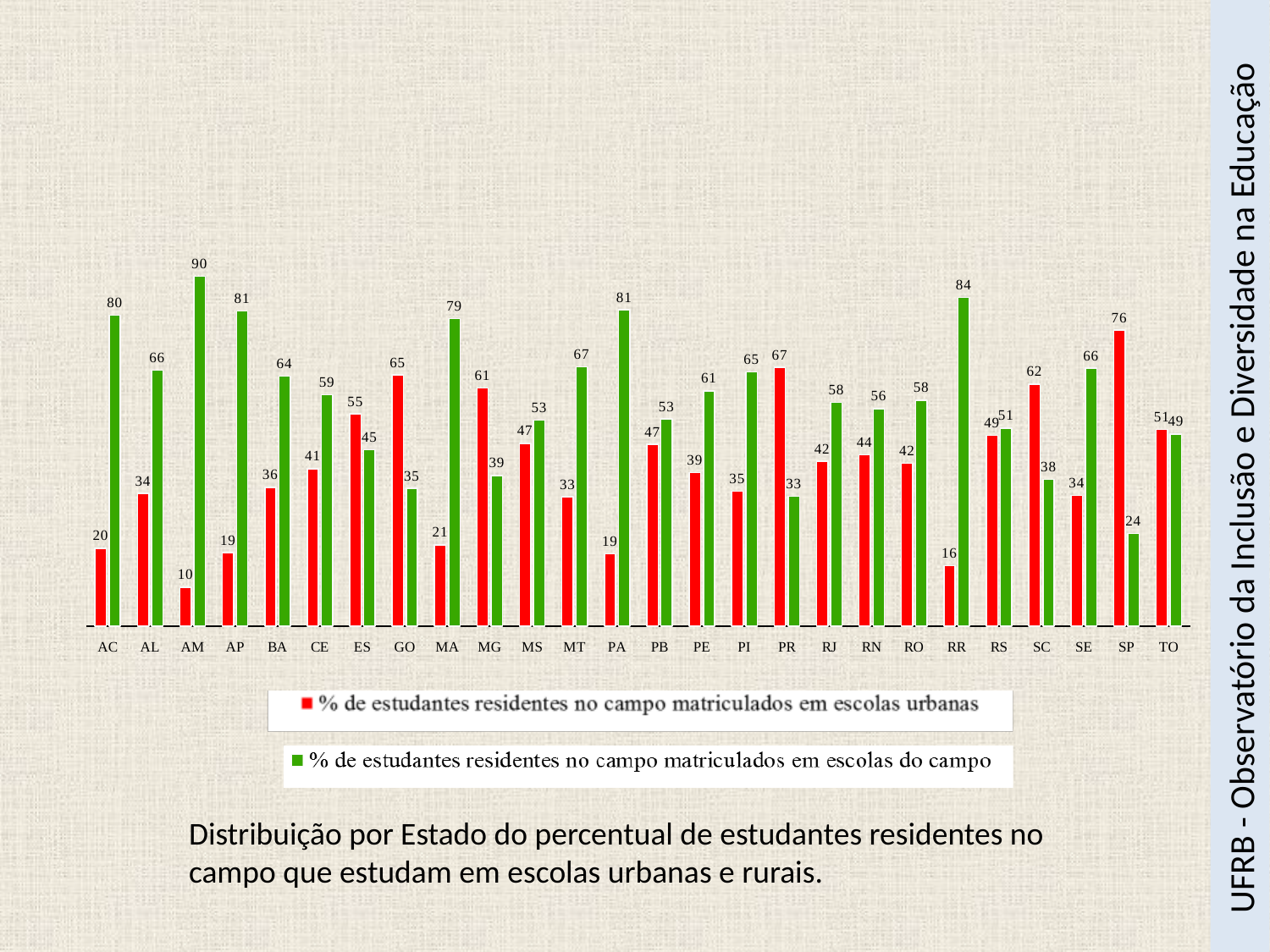
Which state has the highest value in the series '% de estudantes residentes no campo matriculados em escolas do campo'? AM What kind of chart is shown on the slide? bar chart What is the value for AM in the series '% de estudantes residentes no campo matriculados em escolas do campo'? 90 How many series does the legend list? 2 Which colour represents the series '% de estudantes residentes no campo matriculados em escolas do campo'? green Which state has the lowest value in the series '% de estudantes residentes no campo matriculados em escolas do campo'? SP Which state has the lowest value in the series '% de estudantes residentes no campo matriculados em escolas urbanas'? AM For PR, which series has the larger value: escolas urbanas or escolas do campo? escolas urbanas How many states are shown on the x axis? 26 What is the value for SP in the series '% de estudantes residentes no campo matriculados em escolas urbanas'? 76 What is the value for RR in the series '% de estudantes residentes no campo matriculados em escolas urbanas'? 16 What is the difference between the two series' values for RR? 68